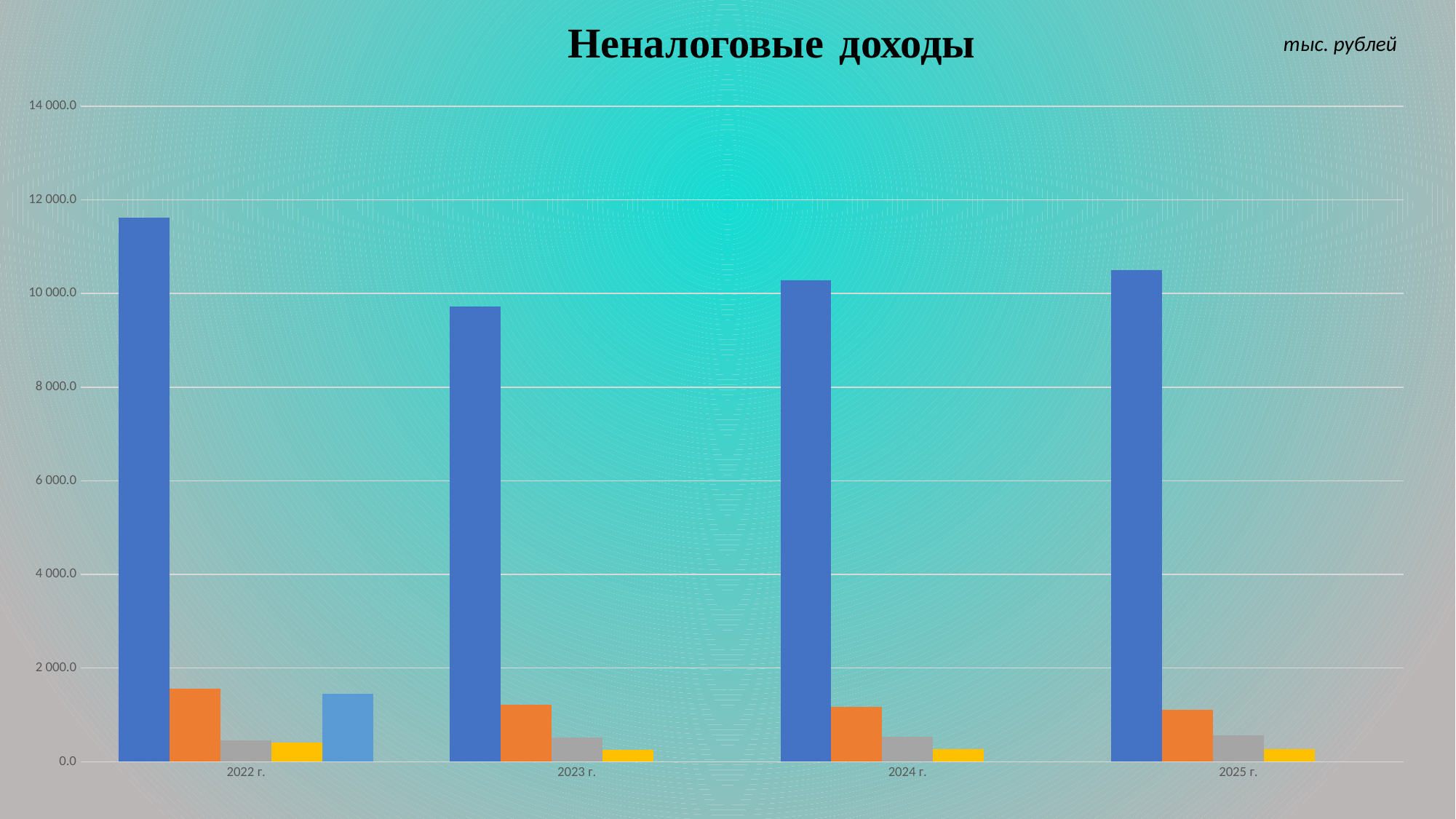
Is the value of the tallest (dark blue) bar for 2022 г. greater or less than 10 000.0? greater Is the value of the orange bar for 2022 г. greater or less than 2 000.0? less Is the value of the tallest (dark blue) bar for 2023 г. greater or less than 10 000.0? less In which year is the dark blue bar the lowest? 2023 г. In which year is the dark blue bar the highest? 2022 г. What is the title of the chart? Неналоговые доходы Which is larger: the orange bar for 2022 г. or the orange bar for 2023 г.? 2022 г. What kind of chart is shown on the slide? bar chart How many year categories are shown on the x axis? 4 How many bars are in the 2022 г. group? 5 How many bars are in the 2023 г. group? 4 In what units are the values on the chart given, according to the note at the top right? тыс. рублей